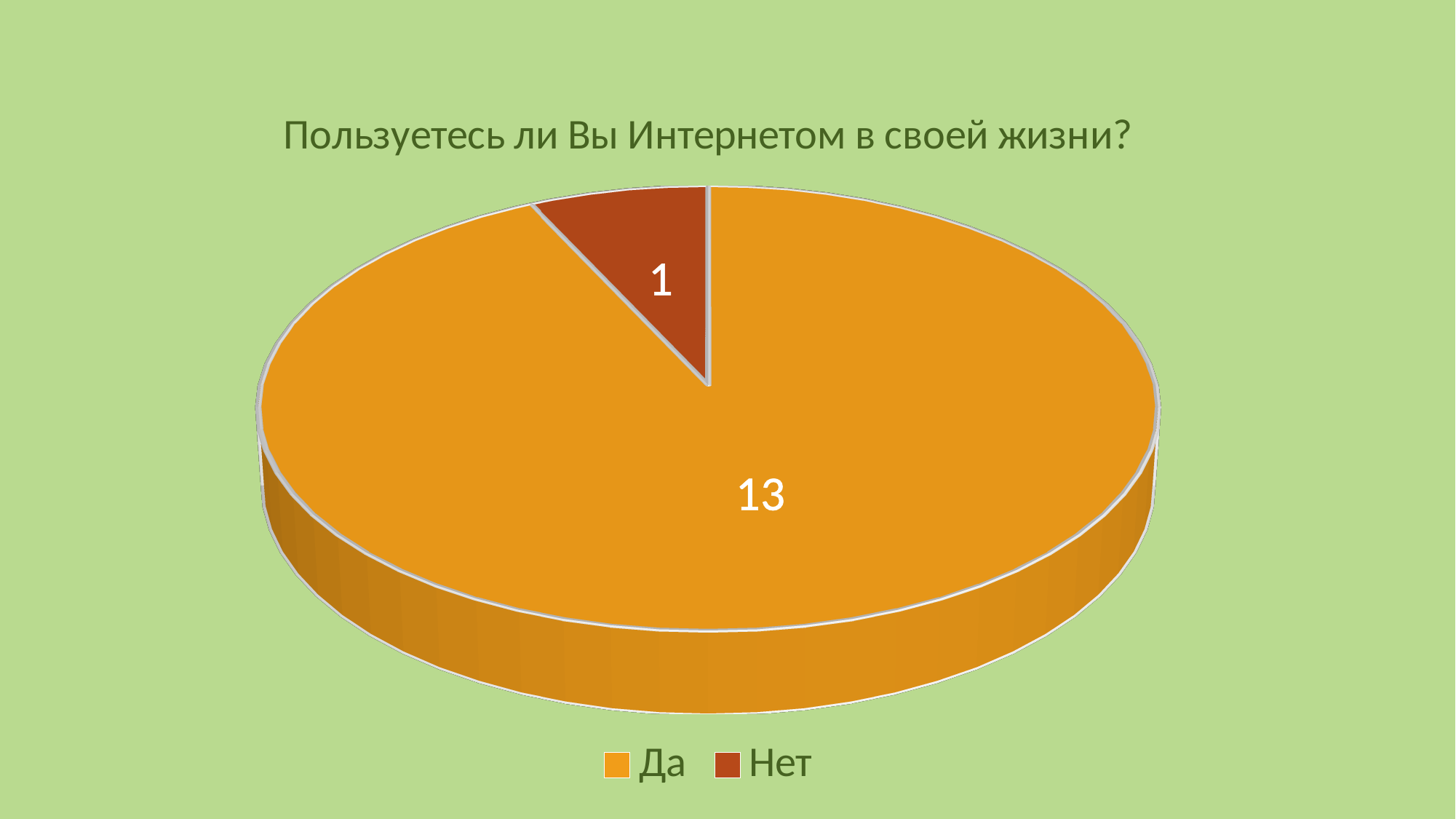
What colour is the slice for Нет? Dark red-brown How many entries does the legend list? 2 What is the value for Нет? 1 What is the total of all slices in the pie chart? 14 Which is larger, the value for Да or the value for Нет? Да What is the difference between the values for Да and Нет? 12 Which category has the largest slice? Да What is the title of the chart? Пользуетесь ли Вы Интернетом в своей жизни? Which category has the smallest slice? Нет What type of chart is shown on the slide? Pie chart What is the value for Да? 13 How many categories does the pie chart have? 2